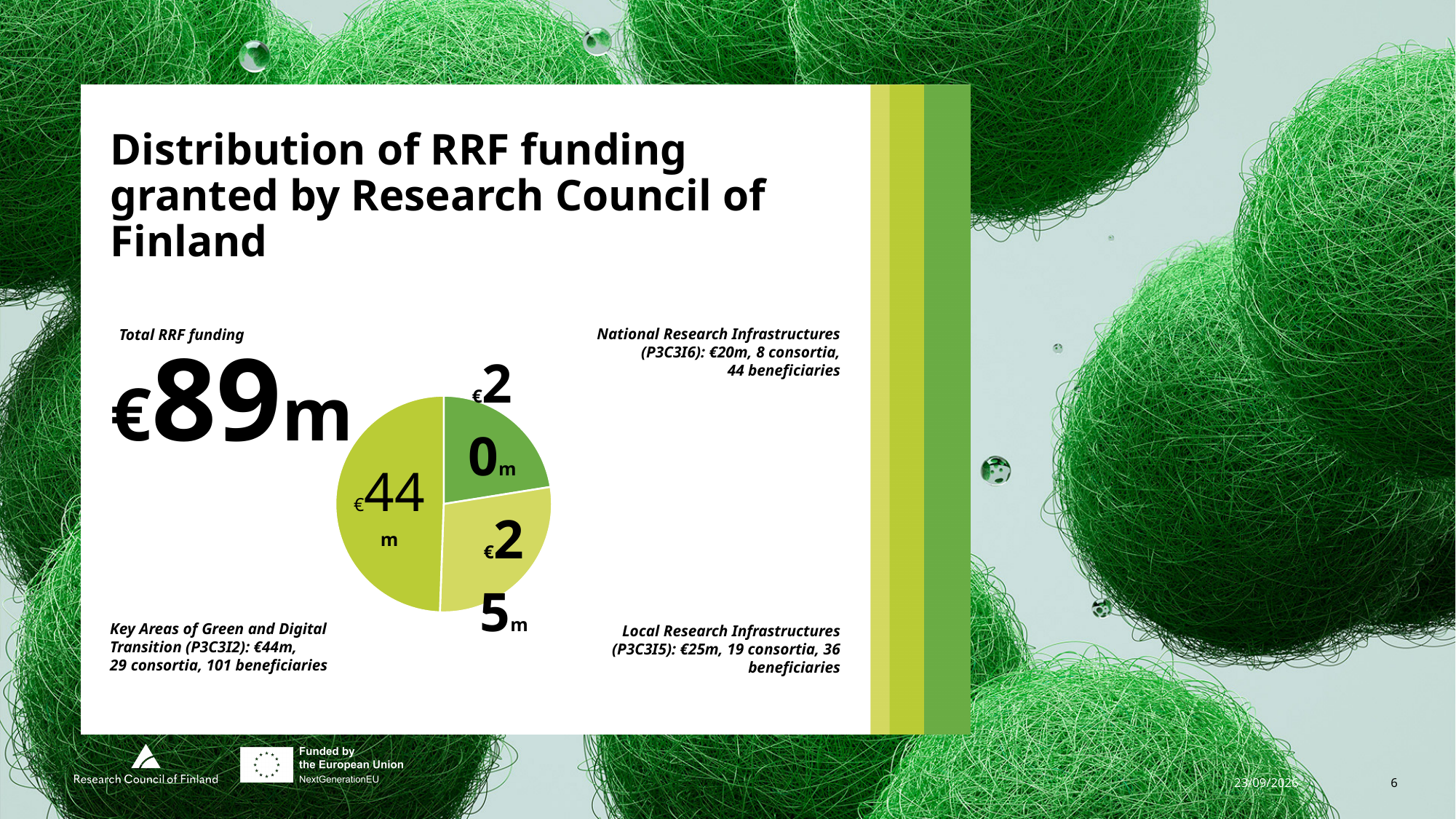
Which funding area received the largest share of RRF funding? Key Areas of Green and Digital Transition (P3C3I2) How many consortia are listed for Local Research Infrastructures (P3C3I5)? 19 What is the RRF funding amount for National Research Infrastructures (P3C3I6)? €20m Which received more RRF funding: Local Research Infrastructures or National Research Infrastructures? Local Research Infrastructures What kind of chart is shown on the slide? pie chart How many beneficiaries are listed for Key Areas of Green and Digital Transition (P3C3I2)? 101 Which funding area received the smallest share of RRF funding? National Research Infrastructures (P3C3I6) What is the RRF funding amount for Key Areas of Green and Digital Transition (P3C3I2)? €44m What is the total RRF funding shown on the slide? €89m What is the difference in funding between Key Areas of Green and Digital Transition and Local Research Infrastructures? €19m What is the RRF funding amount for Local Research Infrastructures (P3C3I5)? €25m How many slices does the pie chart have? 3